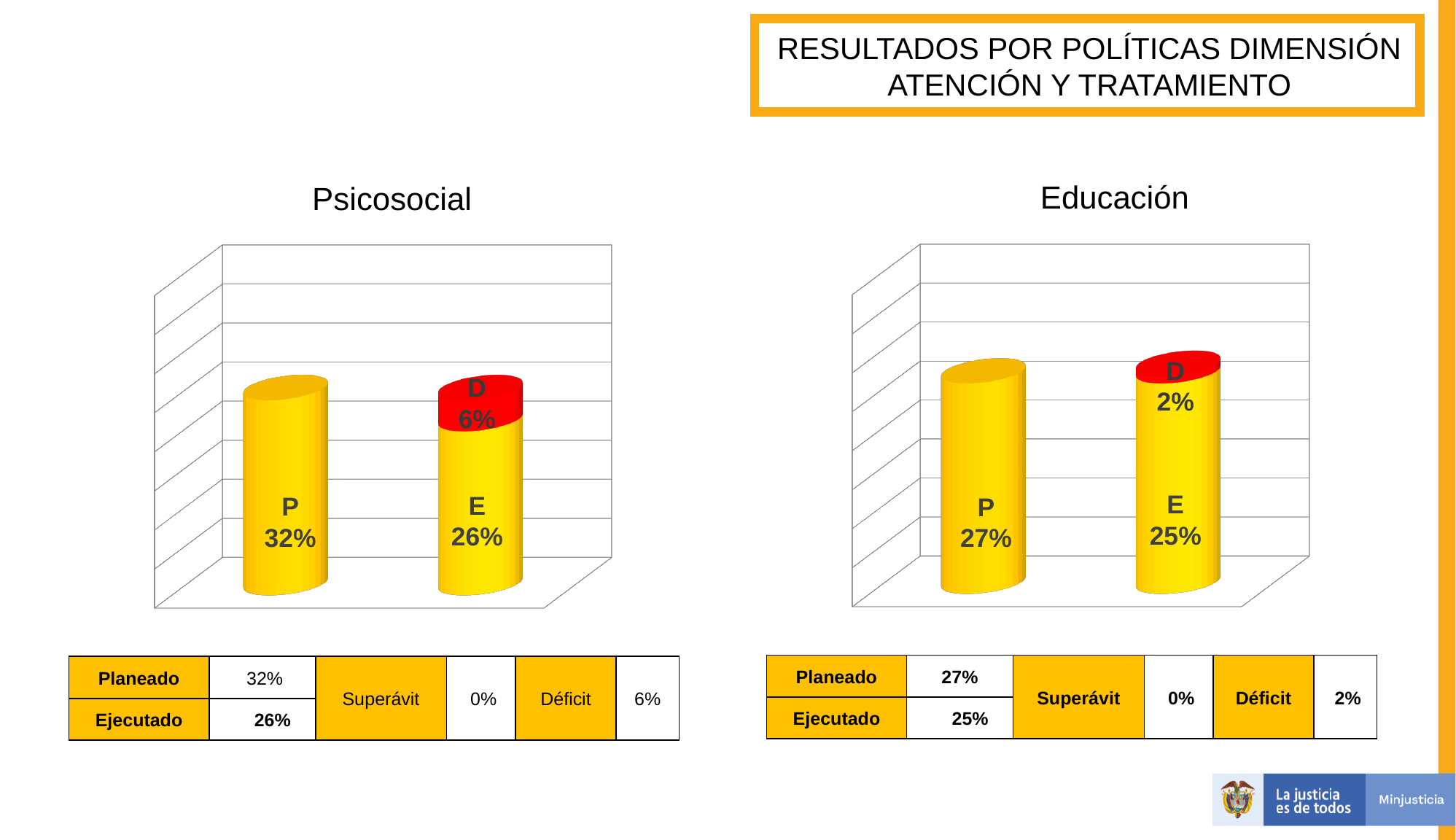
In the Educación chart, what is the value labelled E? 25% In the Psicosocial chart, which is larger, the P value or the E value? P In the Educación chart, what colour is the D segment? Red In the Psicosocial chart, what is the difference between the P value and the E value? 6% In the Educación chart, what is the total of the stacked E bar (E plus D)? 27% In the Psicosocial chart, what is the value labelled P? 32% What kind of chart is the Educación chart? Bar chart In the Educación chart, what is the value labelled P? 27% In the Educación chart, what is the value of the red D segment? 2% How many bars are shown in the Psicosocial chart? 2 In the Psicosocial chart, what is the value labelled E? 26% In the Psicosocial chart, what is the value of the red D segment? 6%